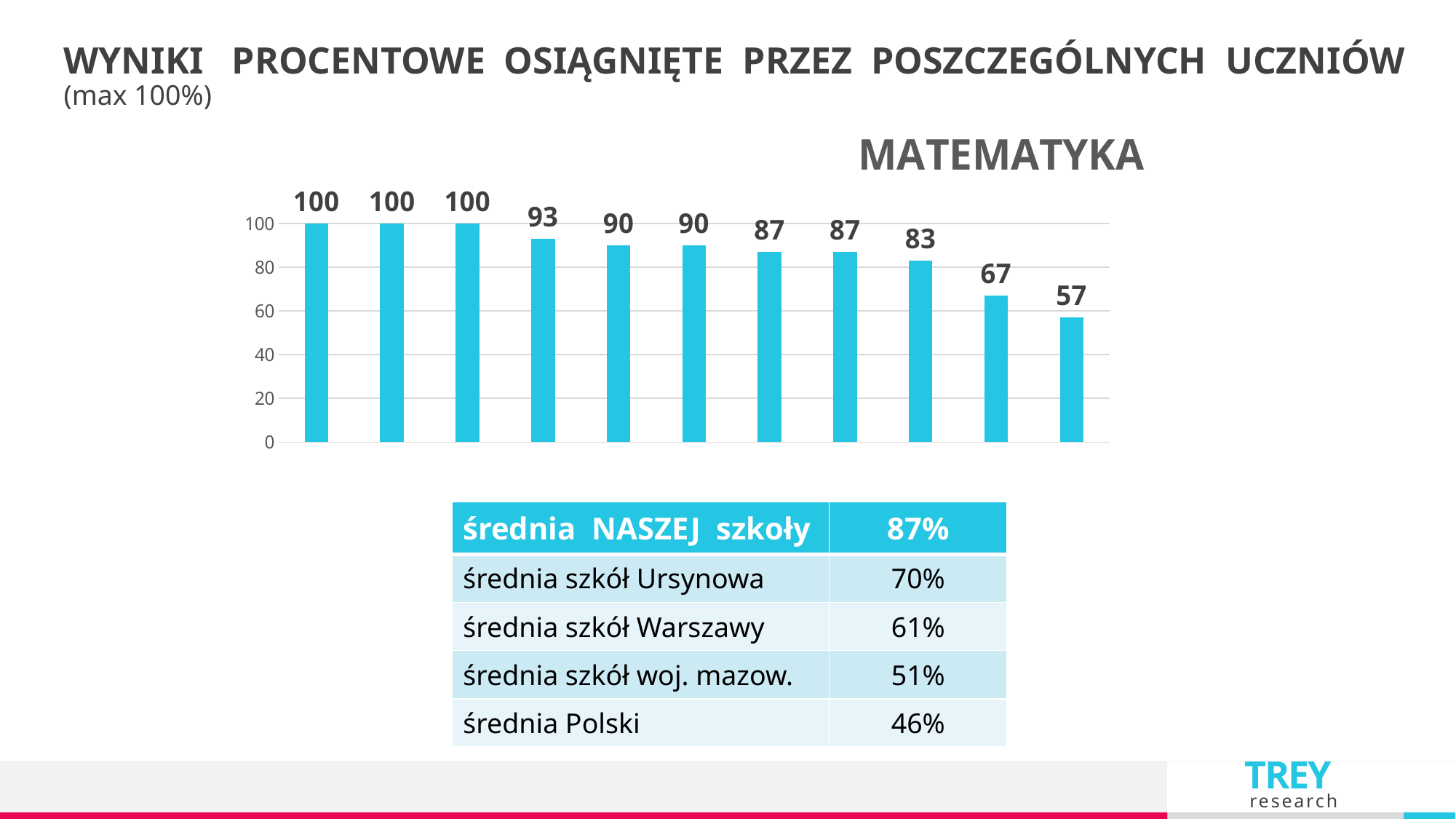
How many bars are plotted in the chart? 11 What is the highest value shown in the chart? 100 Do the bar values rise or fall from left to right across the chart? fall What is the lowest value shown in the chart? 57 What is the value of the tenth bar from the left? 67 Is the value of the rightmost bar greater or less than 60? less What is the value of the first (leftmost) bar in the chart? 100 What is the value of the fourth bar from the left? 93 What kind of chart is shown on the slide? bar chart What is the value of the last (rightmost) bar in the chart? 57 What subject title is shown above the chart? MATEMATYKA What is the difference between the highest bar value and the lowest bar value? 43